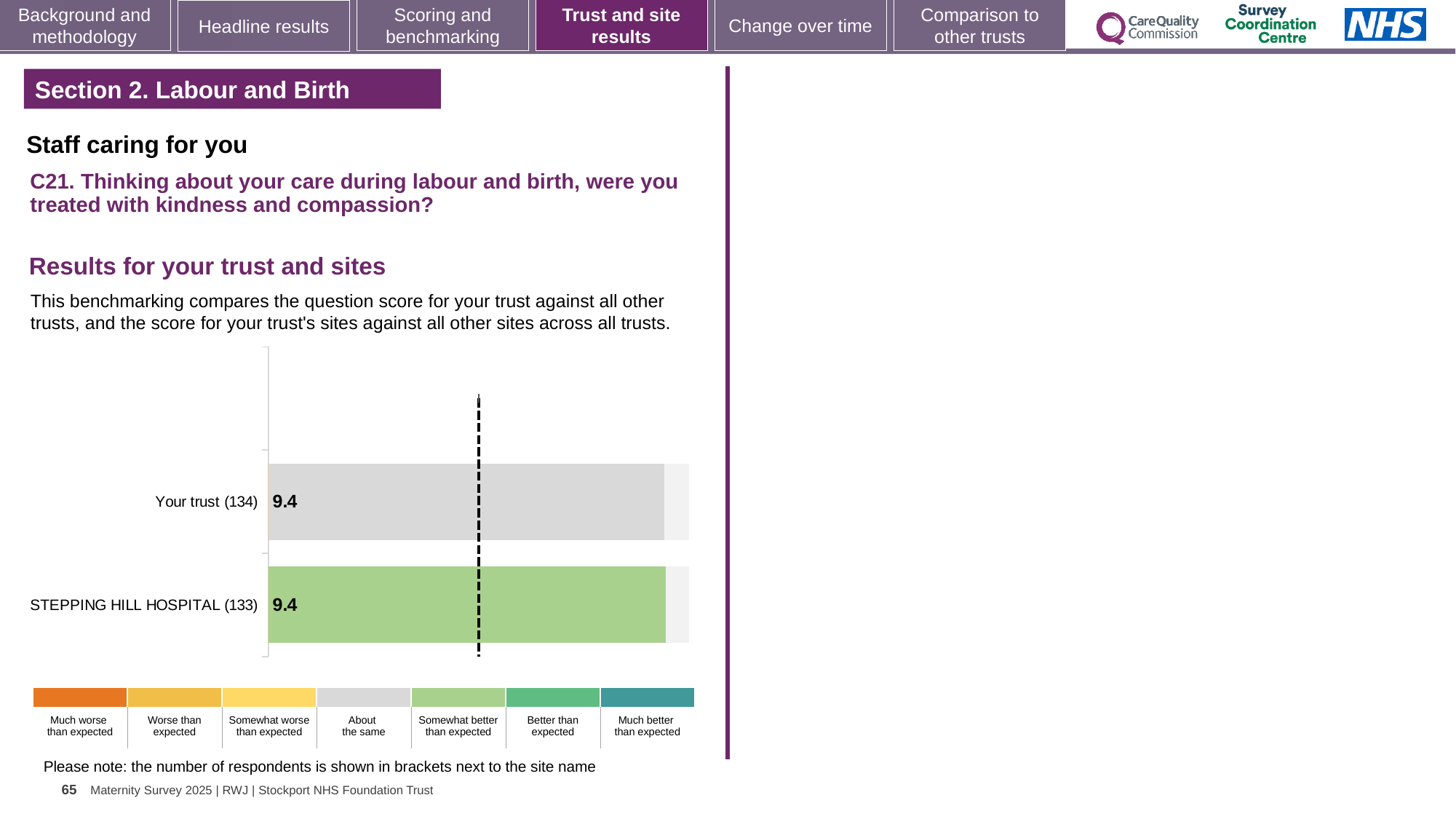
Which benchmark category does the colour of the STEPPING HILL HOSPITAL bar correspond to? Somewhat better than expected How many respondents are shown in brackets for STEPPING HILL HOSPITAL? 133 Which survey question does the chart relate to? C21. Thinking about your care during labour and birth, were you treated with kindness and compassion? How many bars are plotted in the chart? 2 Which benchmark category does the colour of the Your trust bar correspond to? About the same What is the difference between the score for Your trust and the score for STEPPING HILL HOSPITAL? 0 What kind of chart is shown on the slide? Bar chart How many categories does the colour key below the chart list? 7 How many respondents are shown in brackets for Your trust? 134 What is the score for STEPPING HILL HOSPITAL? 9.4 What is the score for Your trust? 9.4